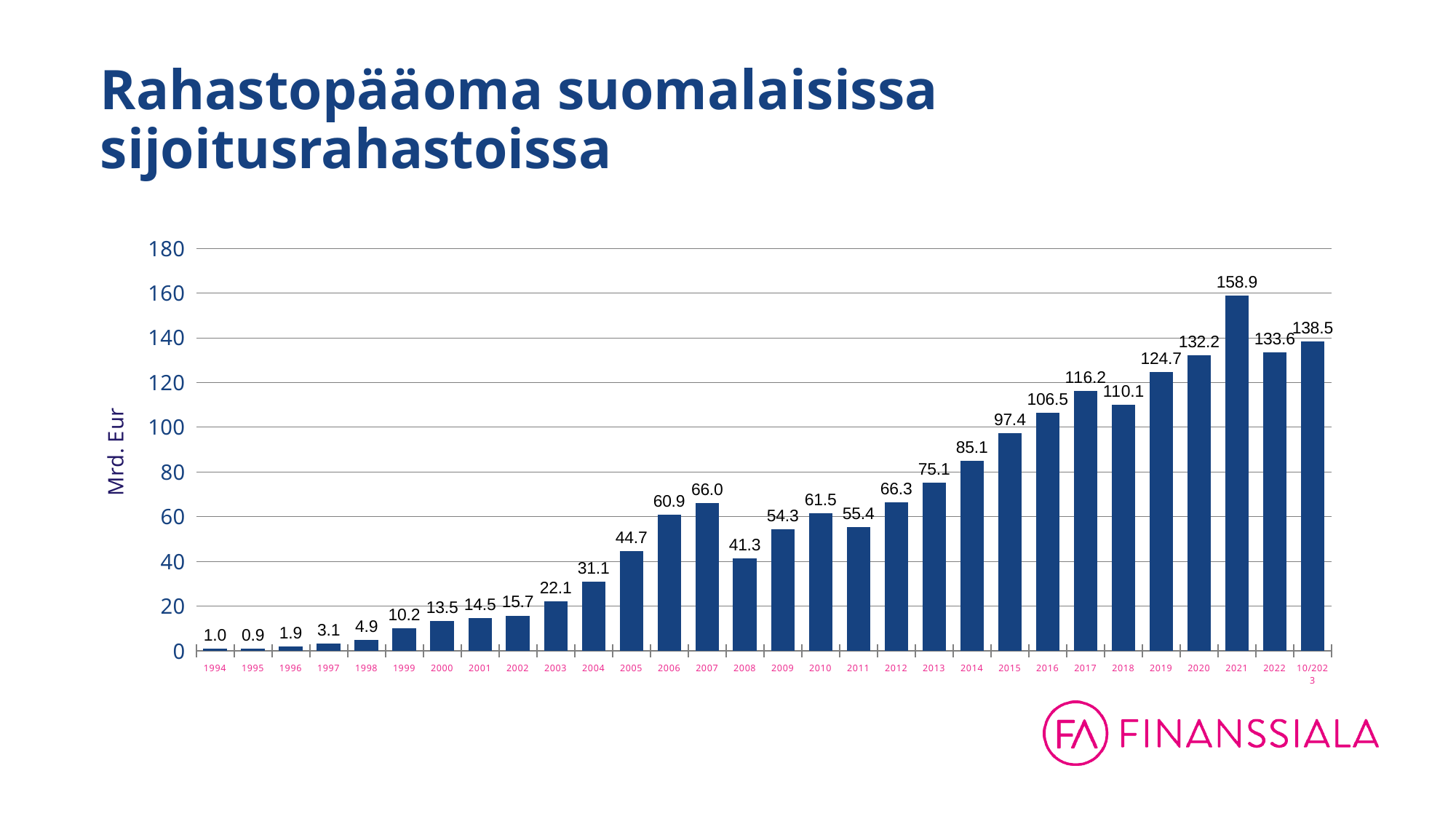
Which year has the highest value? 2021 Which is larger, the value for 2007 or the value for 2010? 2007 What is the label on the vertical axis? Mrd. Eur Is the value for 2019 greater or less than 120? greater Do the values generally rise or fall from 1994 to 2021? Rise What kind of chart is shown on the slide? Bar chart How many bars are plotted in the chart? 30 What is the value for 2008? 41.3 Which year has the lowest value? 1995 What is the value for 2021? 158.9 What is the difference between the values for 2021 and 2022? 25.3 What is the value for 10/2023? 138.5